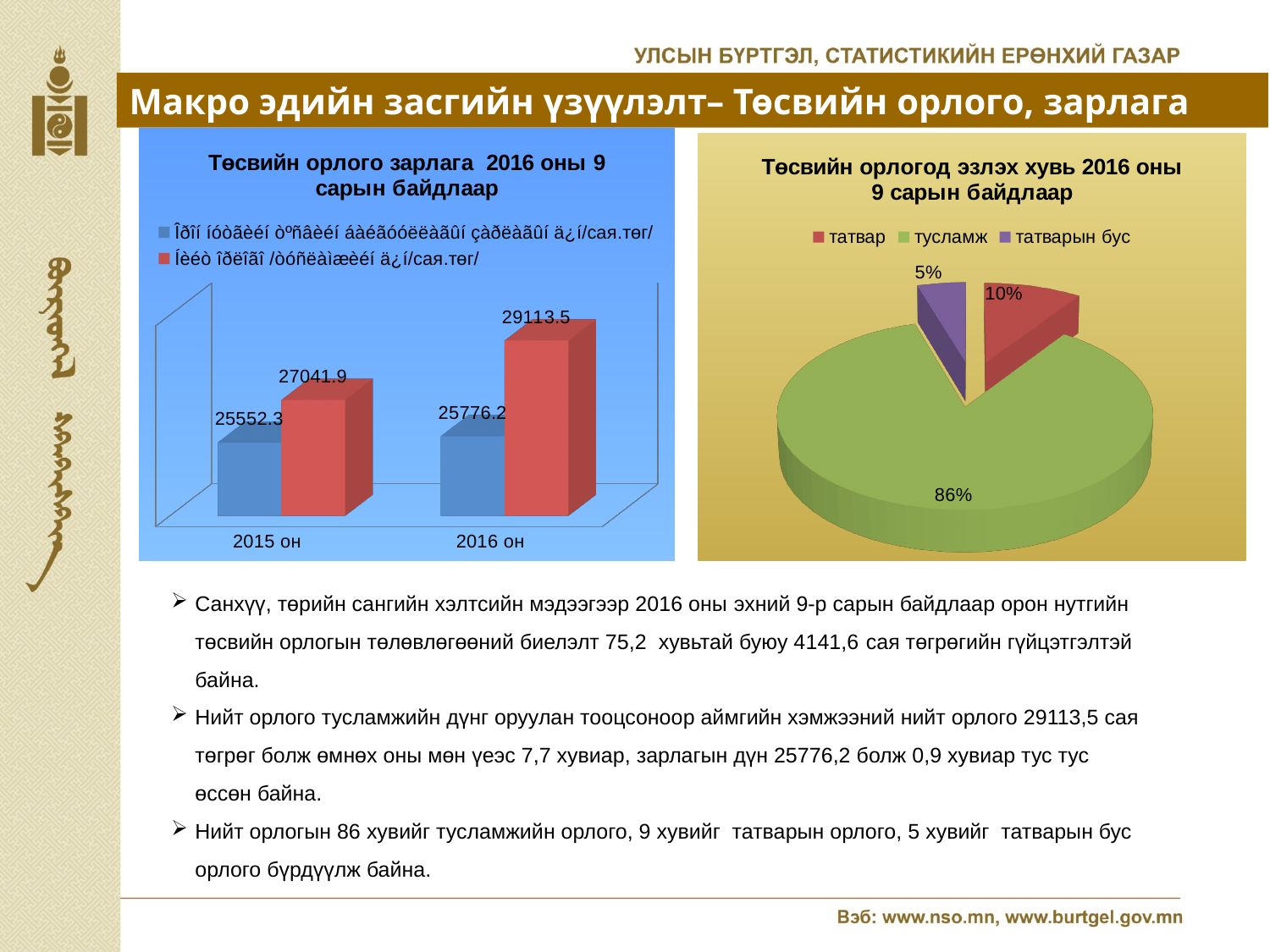
What kind of chart is the left chart titled 'Төсвийн орлого зарлага 2016 оны 9 сарын байдлаар'? bar chart In the left bar chart, what is the value of the blue bar for 2016 он? 25776.2 In the right pie chart, which slice is the smallest? татварын бус In the left bar chart, what is the difference between the red bar values for 2016 он and 2015 он? 2071.6 In the left bar chart, what is the value of the blue bar for 2015 он? 25552.3 What kind of chart is the right chart titled 'Төсвийн орлогод эзлэх хувь 2016 оны 9 сарын байдлаар'? pie chart In the right pie chart, what share does тусламж have? 86% In the left bar chart, what is the value of the red bar for 2015 он? 27041.9 In the left bar chart, what is the value of the red bar for 2016 он? 29113.5 How many series does the legend of the right pie chart list? 3 In the left bar chart, which is larger for 2016 он, the blue bar or the red bar? the red bar How many categories are shown on the x axis of the left bar chart? 2